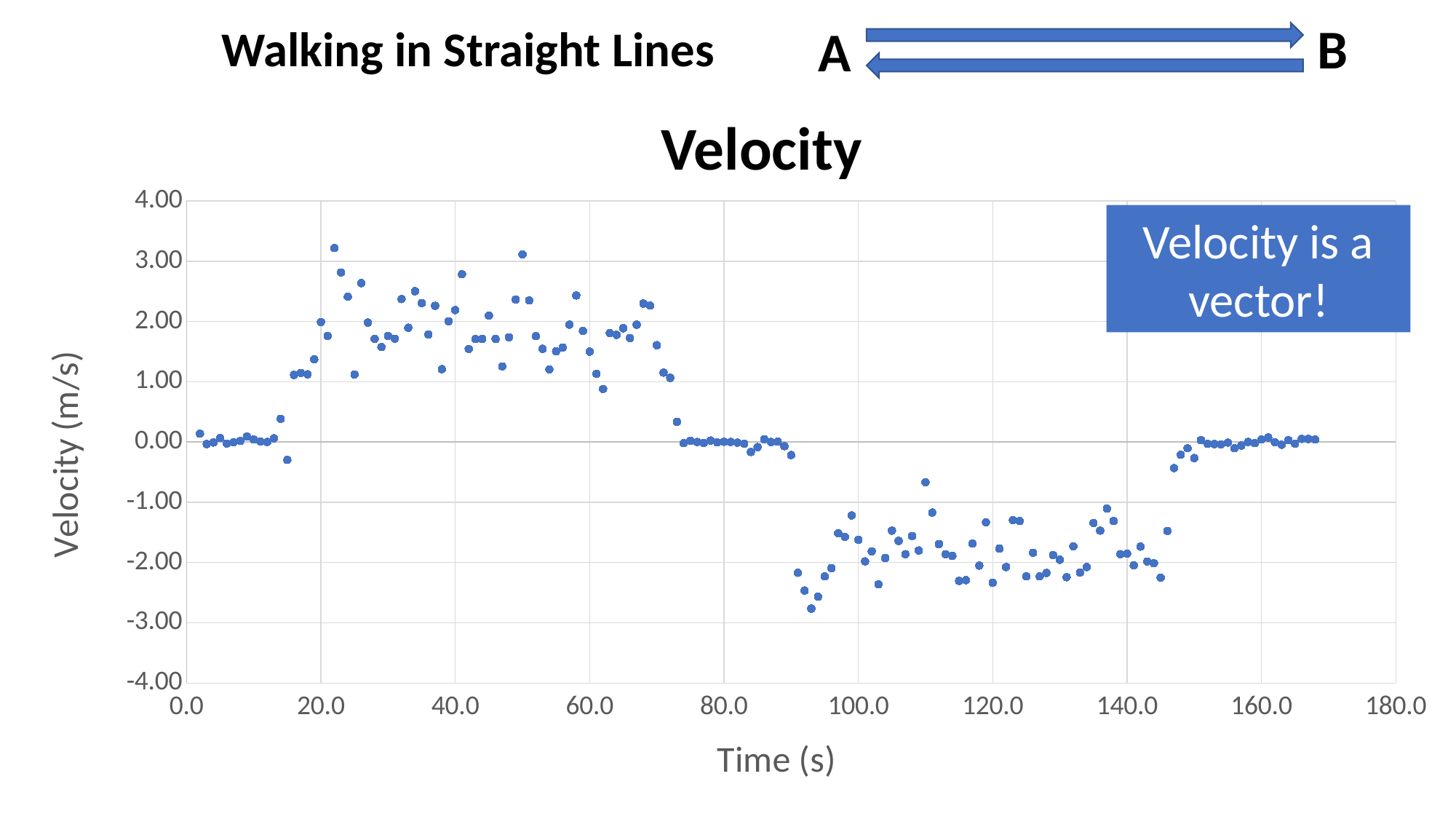
Is the velocity value at around 160 s greater or less than -1.00? greater What kind of chart is shown on the slide? scatter chart Is the highest plotted velocity greater or less than 3.00? greater Between about 70 s and 75 s, do the velocity values rise or fall? fall Is the velocity value at around 120 s greater or less than -1.00? less Between about 145 s and 150 s, do the velocity values rise or fall? rise What is the title of the chart? Velocity Which is larger, the velocity value at around 40 s or the velocity value at around 100 s? the value at around 40 s What is the label of the vertical axis of the chart? Velocity (m/s)